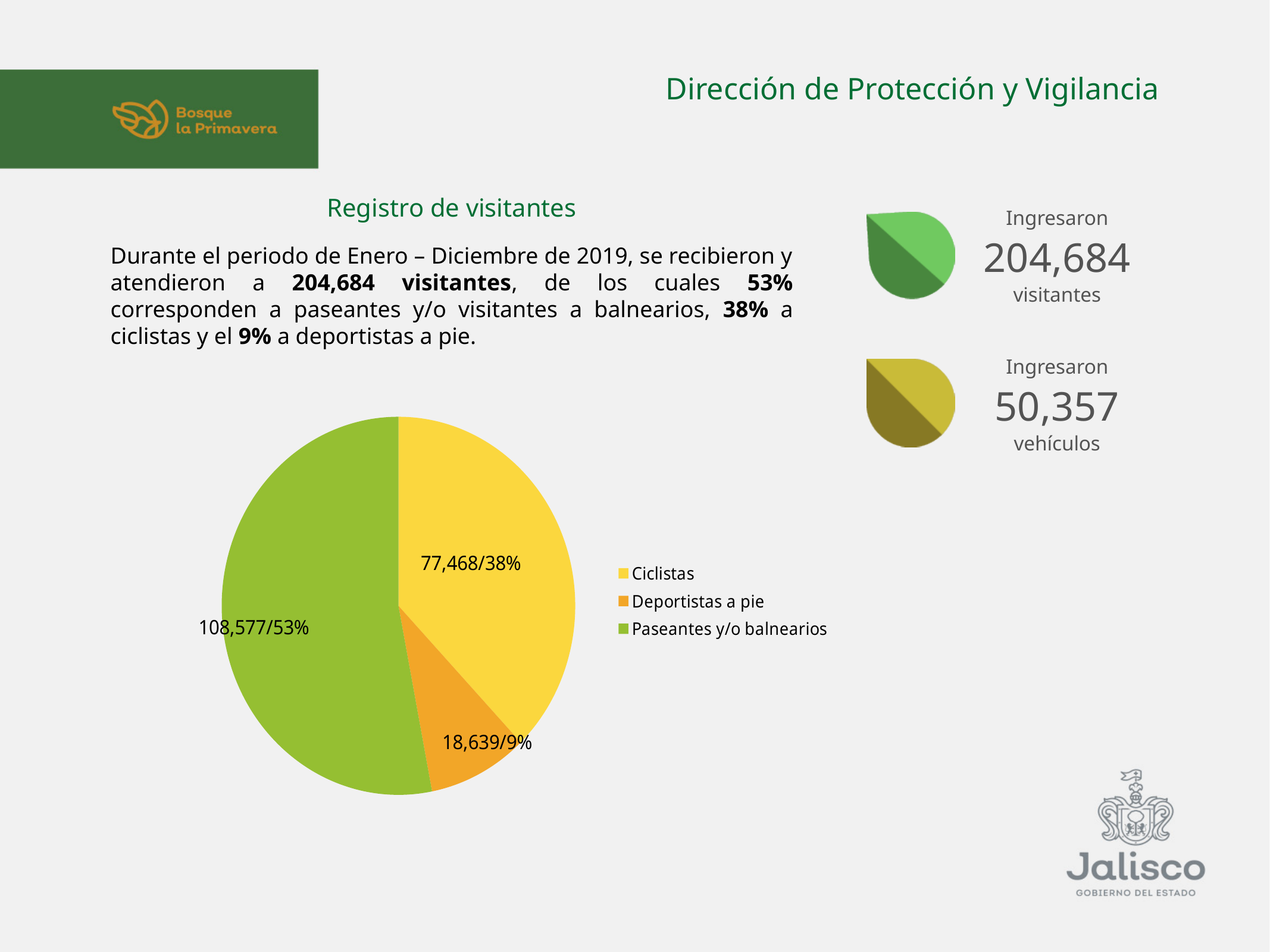
What type of chart is shown on the slide? Pie chart What is the difference between the number of visitors for Paseantes y/o balnearios and Ciclistas? 31,109 Which category has the smallest slice in the pie chart? Deportistas a pie Which category has the largest slice in the pie chart? Paseantes y/o balnearios What share of the pie does Paseantes y/o balnearios represent? 53% What is the number of visitors shown for Deportistas a pie in the pie chart? 18,639 What share of the pie does Ciclistas represent? 38% How many entries does the legend of the pie chart list? 3 What is the number of visitors shown for Paseantes y/o balnearios in the pie chart? 108,577 Which colour represents Deportistas a pie in the pie chart? Orange How many slices does the pie chart have? 3 What is the number of visitors shown for Ciclistas in the pie chart? 77,468